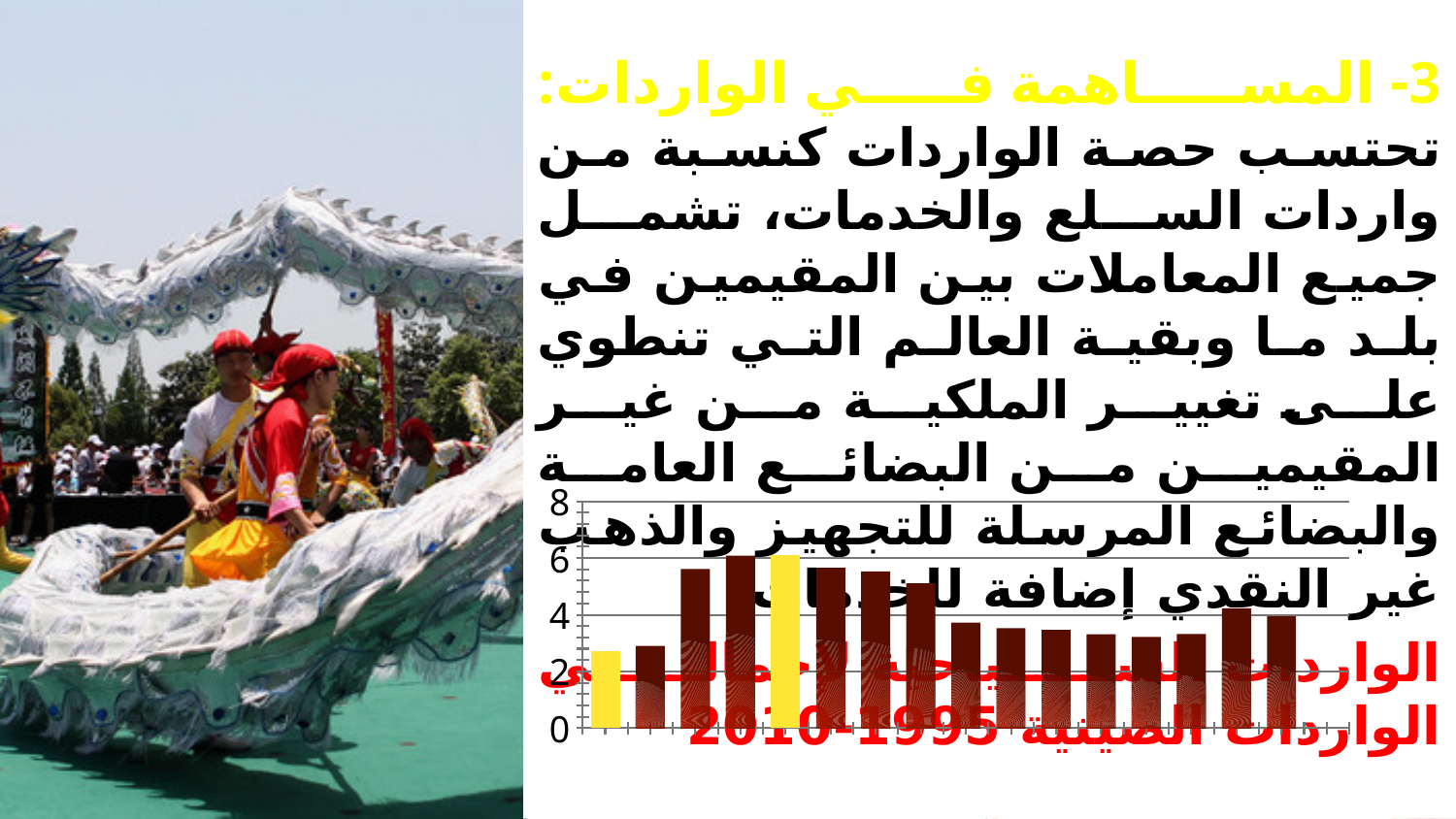
Which years does the chart title say the data covers? 1995-2010 How many bars are plotted on the chart? 16 What kind of chart is shown on the slide? bar chart Is the value of the fourth bar from the left greater or less than 4? greater Do the bar values rise or fall from the fifth bar to the thirteenth bar along the x axis? fall Is the value of the rightmost bar greater or less than 6? less Is the value of the third bar from the left greater or less than 4? greater Which is larger, the third bar from the left or the rightmost bar? the third bar from the left What is the highest value shown on the chart's vertical axis? 8 Which is larger, the leftmost bar or the fourth bar from the left? the fourth bar from the left